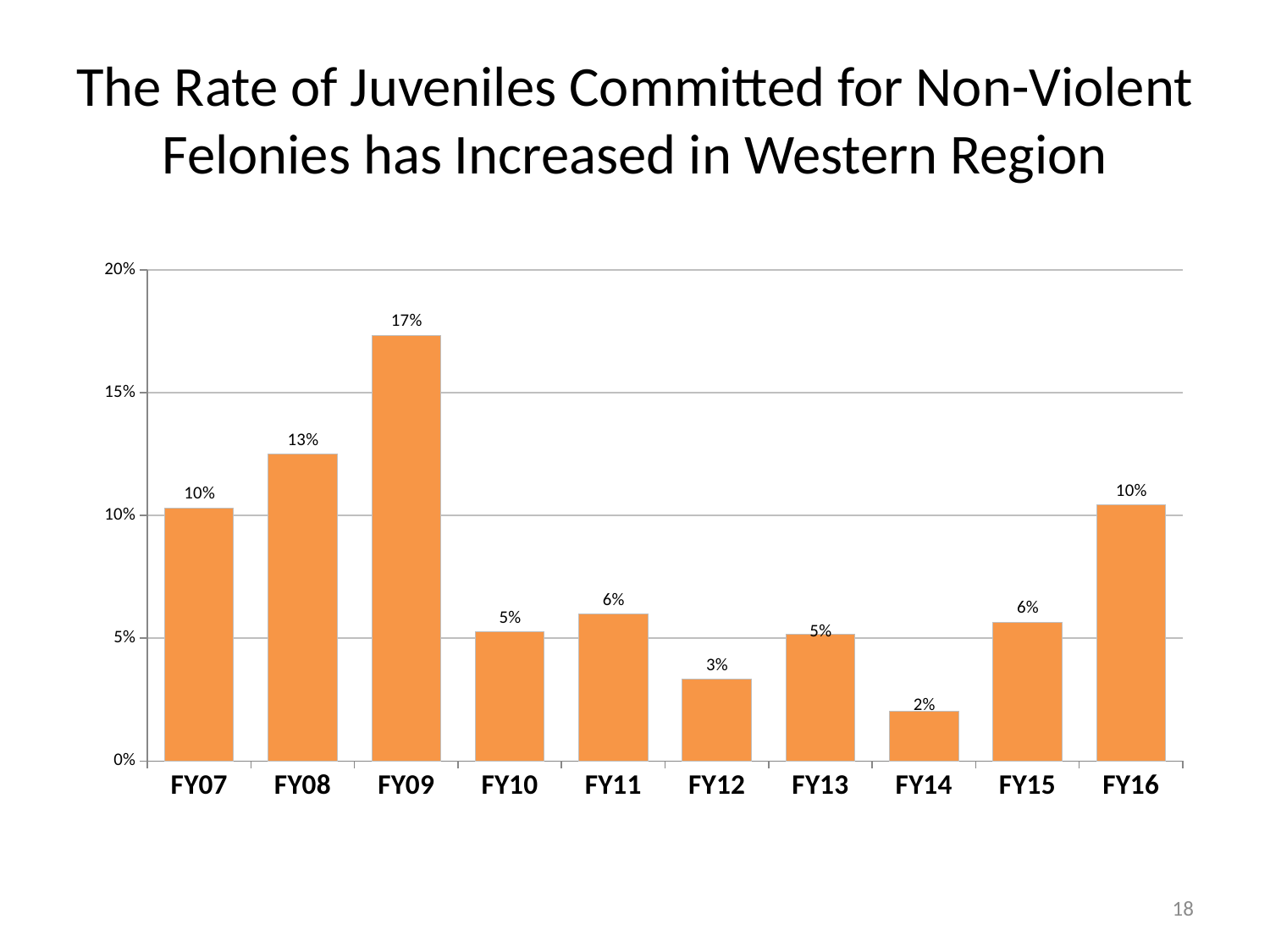
What is the difference between the values for FY09 and FY08? 4% What is the value for FY09? 17% Which fiscal year has the highest value? FY09 What is the value for FY12? 3% What colour are the bars in the chart? orange How many fiscal years are shown on the x axis? 10 What kind of chart is shown on the slide? bar chart What is the value for FY14? 2% Which fiscal year has the lowest value? FY14 Which is larger, the value for FY08 or the value for FY16? FY08 Is the value for FY09 greater or less than 15%? greater Do the values rise or fall from FY09 to FY10? fall